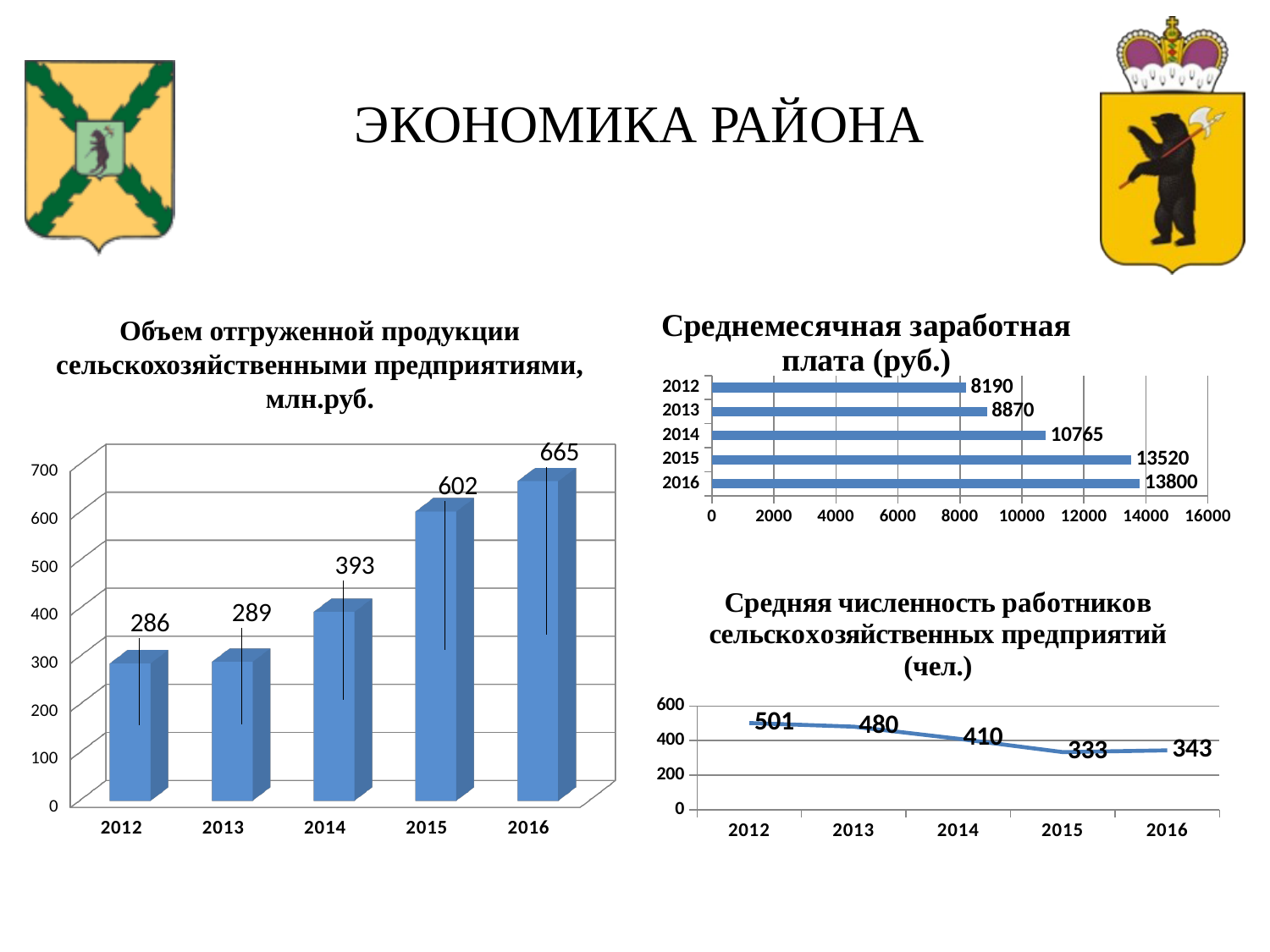
In the chart 'Объем отгруженной продукции сельскохозяйственными предприятиями, млн.руб.', which year has the highest value? 2016 In the chart 'Среднемесячная заработная плата (руб.)', what is the value for 2014? 10765 In the chart 'Средняя численность работников сельскохозяйственных предприятий (чел.)', what is the difference between the values for 2012 and 2013? 21 What kind of chart is 'Средняя численность работников сельскохозяйственных предприятий (чел.)'? line chart In the chart 'Средняя численность работников сельскохозяйственных предприятий (чел.)', which is larger, the value for 2012 or the value for 2016? 2012 In the chart 'Среднемесячная заработная плата (руб.)', do the values rise or fall from 2012 to 2016? rise In the chart 'Объем отгруженной продукции сельскохозяйственными предприятиями, млн.руб.', what is the difference between the values for 2016 and 2015? 63 In the chart 'Средняя численность работников сельскохозяйственных предприятий (чел.)', what is the value for 2015? 333 In the chart 'Среднемесячная заработная плата (руб.)', which year has the lowest value? 2012 In the chart 'Среднемесячная заработная плата (руб.)', how many years are shown? 5 In the chart 'Объем отгруженной продукции сельскохозяйственными предприятиями, млн.руб.', what is the value for 2014? 393 What kind of chart is 'Объем отгруженной продукции сельскохозяйственными предприятиями, млн.руб.'? bar chart